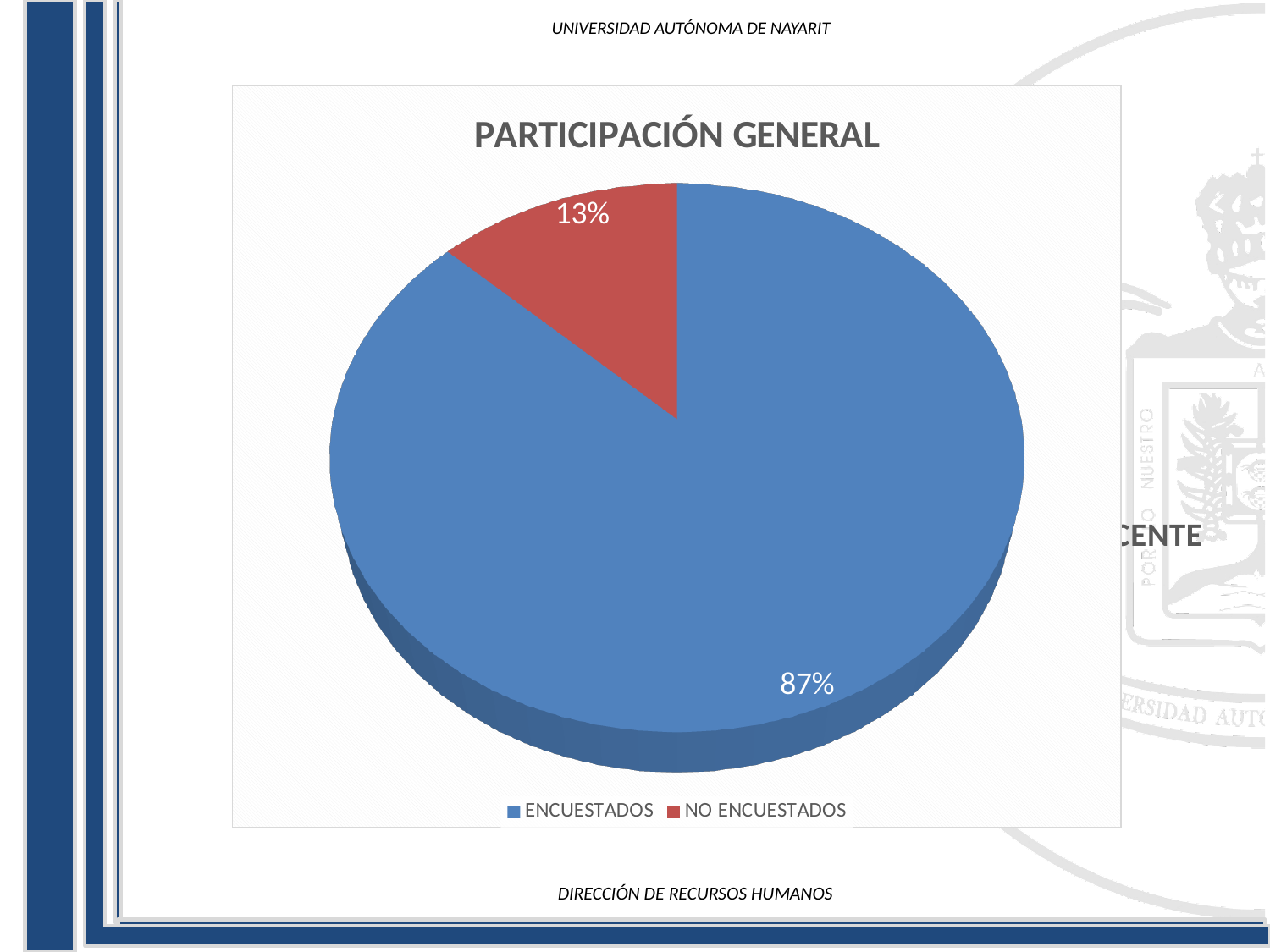
What kind of chart is shown on the slide? pie chart What is the title of the chart? PARTICIPACIÓN GENERAL How many slices does the pie chart have? 2 Which is larger, the slice for ENCUESTADOS or the slice for NO ENCUESTADOS? ENCUESTADOS Which category has the smallest slice of the pie? NO ENCUESTADOS What is the difference in percentage points between ENCUESTADOS and NO ENCUESTADOS? 74% Which category has the largest slice of the pie? ENCUESTADOS What colour is the slice for NO ENCUESTADOS? red What share of the pie does NO ENCUESTADOS represent? 13% How many entries does the legend list? 2 What share of the pie does ENCUESTADOS represent? 87%